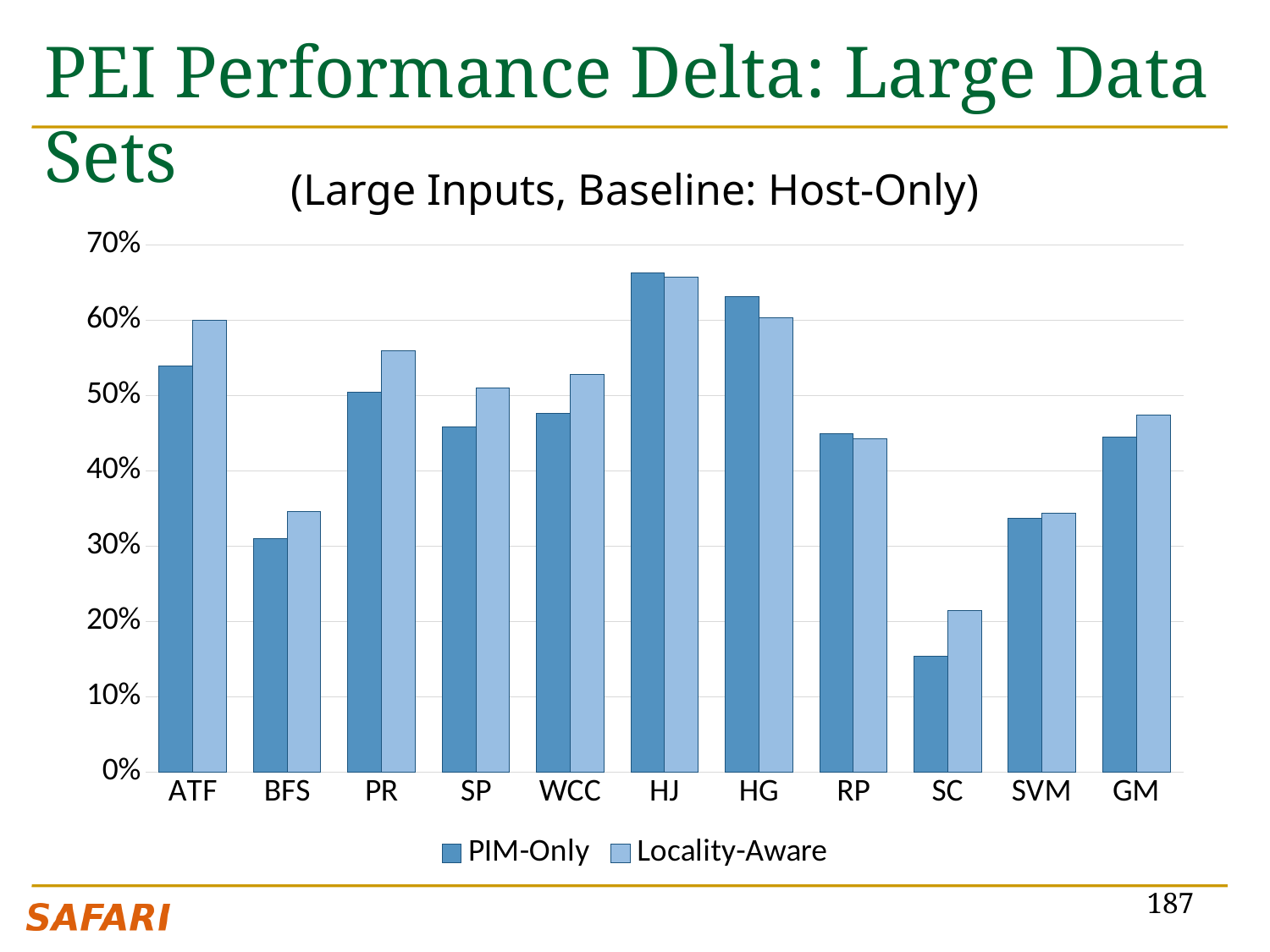
Is the PIM-Only value for HG greater or less than 60%? greater Which category has the lowest Locality-Aware value? SC Is the PIM-Only value for SC greater or less than 20%? less What kind of chart is shown on the slide? bar chart How many categories are shown along the x axis? 11 Which category has the highest PIM-Only value? HJ What are the two series named in the legend? PIM-Only and Locality-Aware Which category has the lowest PIM-Only value? SC Is the Locality-Aware value for BFS greater or less than 40%? less How many series does the legend list? 2 For ATF, which series has the larger value, PIM-Only or Locality-Aware? Locality-Aware